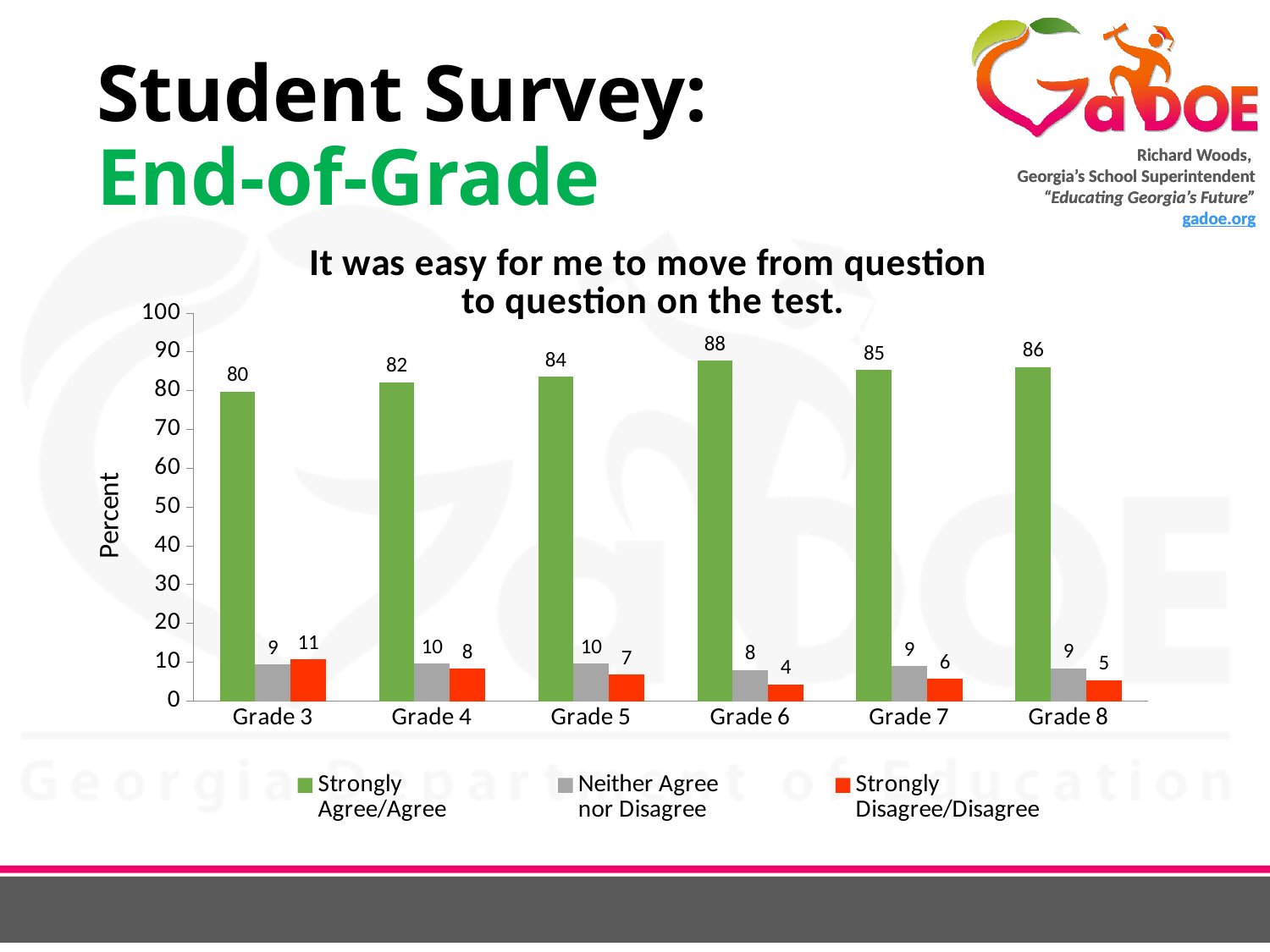
Is the Strongly Agree/Agree value for Grade 5 greater or less than 70? greater Which grade has the lowest Strongly Disagree/Disagree value? Grade 6 What is the Strongly Agree/Agree value for Grade 6? 88 Which is larger, the Strongly Disagree/Disagree value for Grade 3 or for Grade 8? Grade 3 How many grades are shown on the x axis? 6 What is the Neither Agree nor Disagree value for Grade 4? 10 How many series does the legend list? 3 What kind of chart is shown on the slide? bar chart Which grade has the highest Strongly Agree/Agree value? Grade 6 What is the difference between the Strongly Agree/Agree values for Grade 6 and Grade 3? 8 What is the label of the y axis? Percent What is the Strongly Disagree/Disagree value for Grade 3? 11